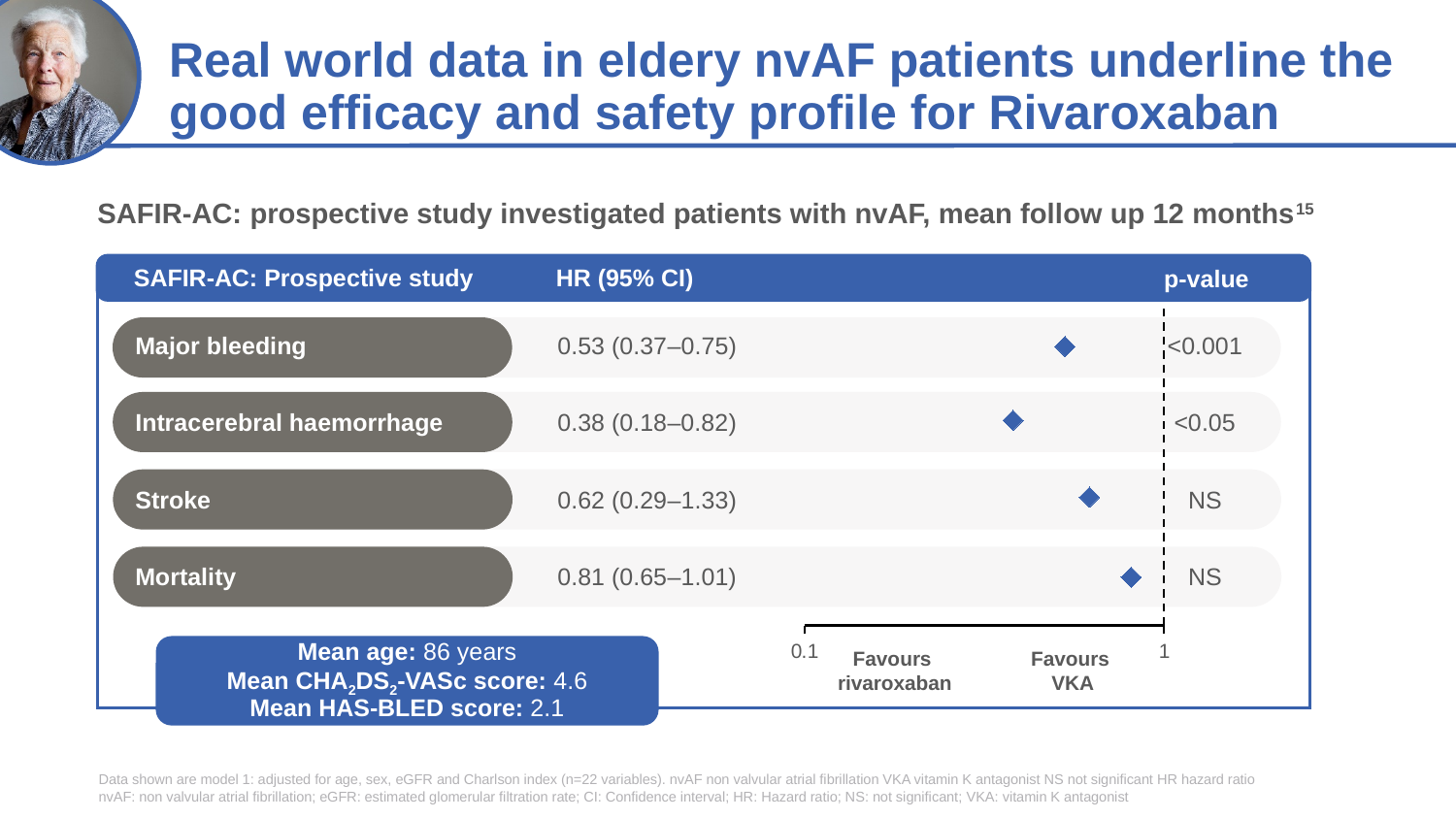
What is the hazard ratio (95% CI) for intracerebral haemorrhage? 0.38 (0.18–0.82) Which outcome has the lowest hazard ratio? Intracerebral haemorrhage Which has the larger hazard ratio, stroke or major bleeding? Stroke Is the hazard ratio point for mortality greater or less than 1? less What does the left side of the hazard ratio axis favour, according to the axis label? Favours rivaroxaban What is the difference between the hazard ratio for mortality and the hazard ratio for intracerebral haemorrhage? 0.43 What is the hazard ratio (95% CI) for mortality? 0.81 (0.65–1.01) What is the hazard ratio (95% CI) for stroke? 0.62 (0.29–1.33) Which outcome has the highest hazard ratio? Mortality What is the p-value for major bleeding? <0.001 How many outcomes are plotted in the forest plot? 4 What is the hazard ratio (95% CI) for major bleeding? 0.53 (0.37–0.75)